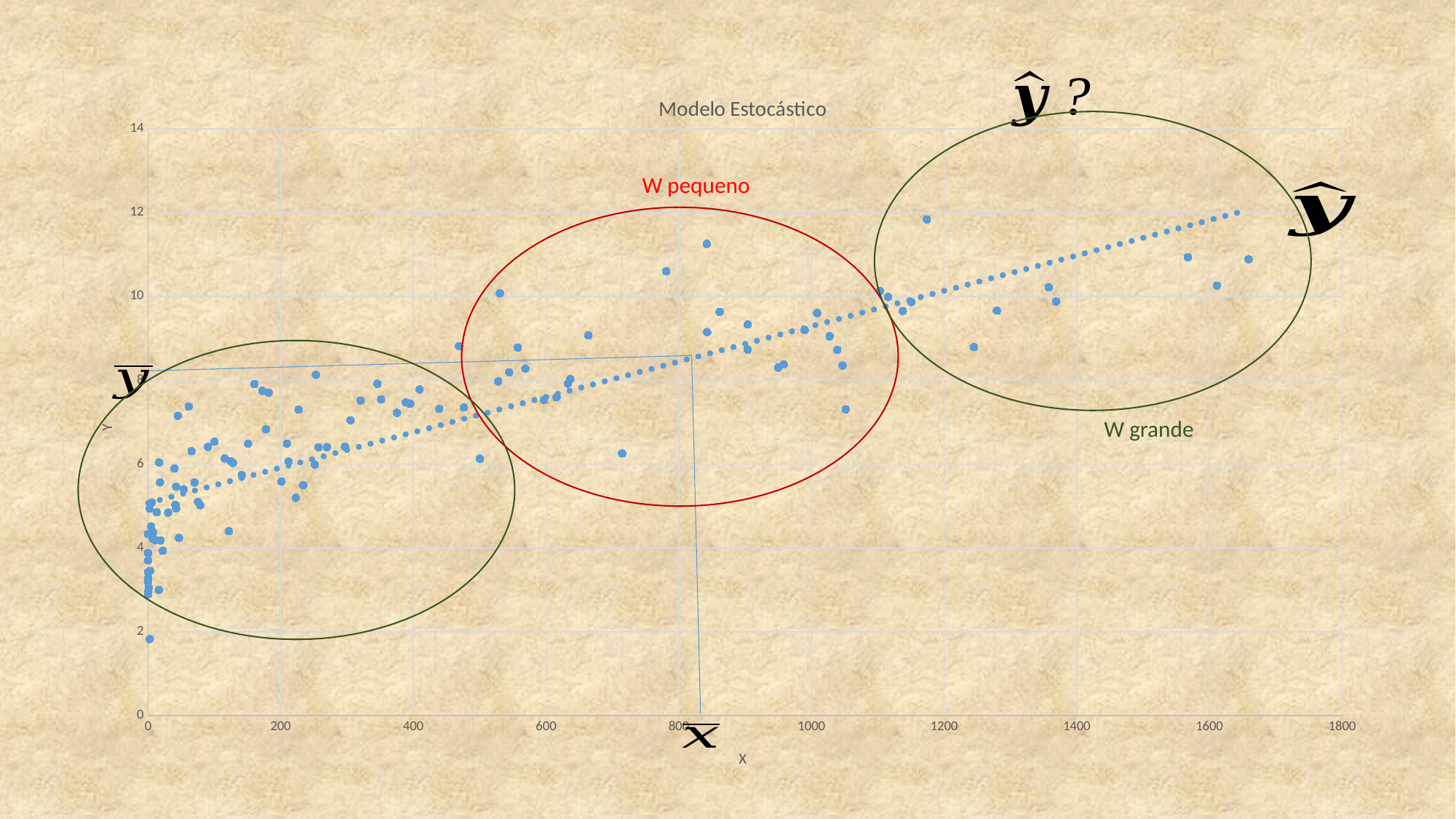
What is the highest tick value shown on the y axis? 14 What is the title of the chart? Modelo Estocástico Is the x value of the rightmost plotted point greater or less than 1800? less Is the y value of the lowest plotted point greater or less than 4? less What kind of chart is shown on the slide? scatter chart Is the y value where the dotted trend line ends at the right greater or less than 10? greater What is the label of the horizontal axis? X What is the highest tick value shown on the x axis? 1800 What label is written next to the green ellipse on the right? W grande Do the plotted values generally rise or fall as x increases along the x axis? rise What label is written next to the red ellipse? W pequeno